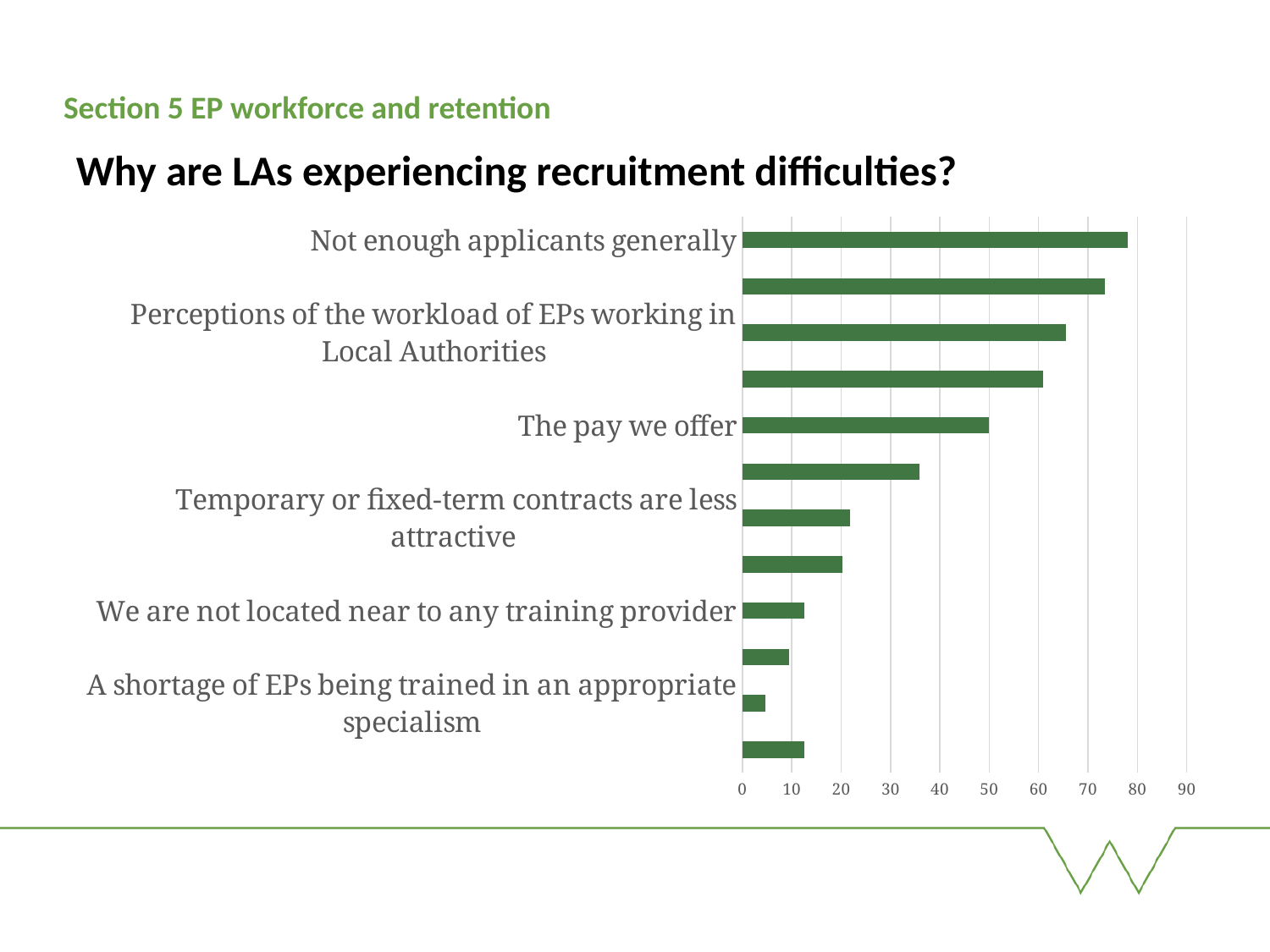
Which labelled reason has the shortest bar in the chart? A shortage of EPs being trained in an appropriate specialism What is the title of the chart on the slide? Why are LAs experiencing recruitment difficulties? Is the value for "A shortage of EPs being trained in an appropriate specialism" greater or less than 10? less Is the value for "Temporary or fixed-term contracts are less attractive" greater or less than 30? less Which is larger, the value for "The pay we offer" or the value for "Temporary or fixed-term contracts are less attractive"? The pay we offer Is the value for "Perceptions of the workload of EPs working in Local Authorities" greater or less than 60? greater What is the highest value shown on the horizontal axis of the chart? 90 What kind of chart is shown on the slide? bar chart Which labelled reason has the longest bar in the chart? Not enough applicants generally